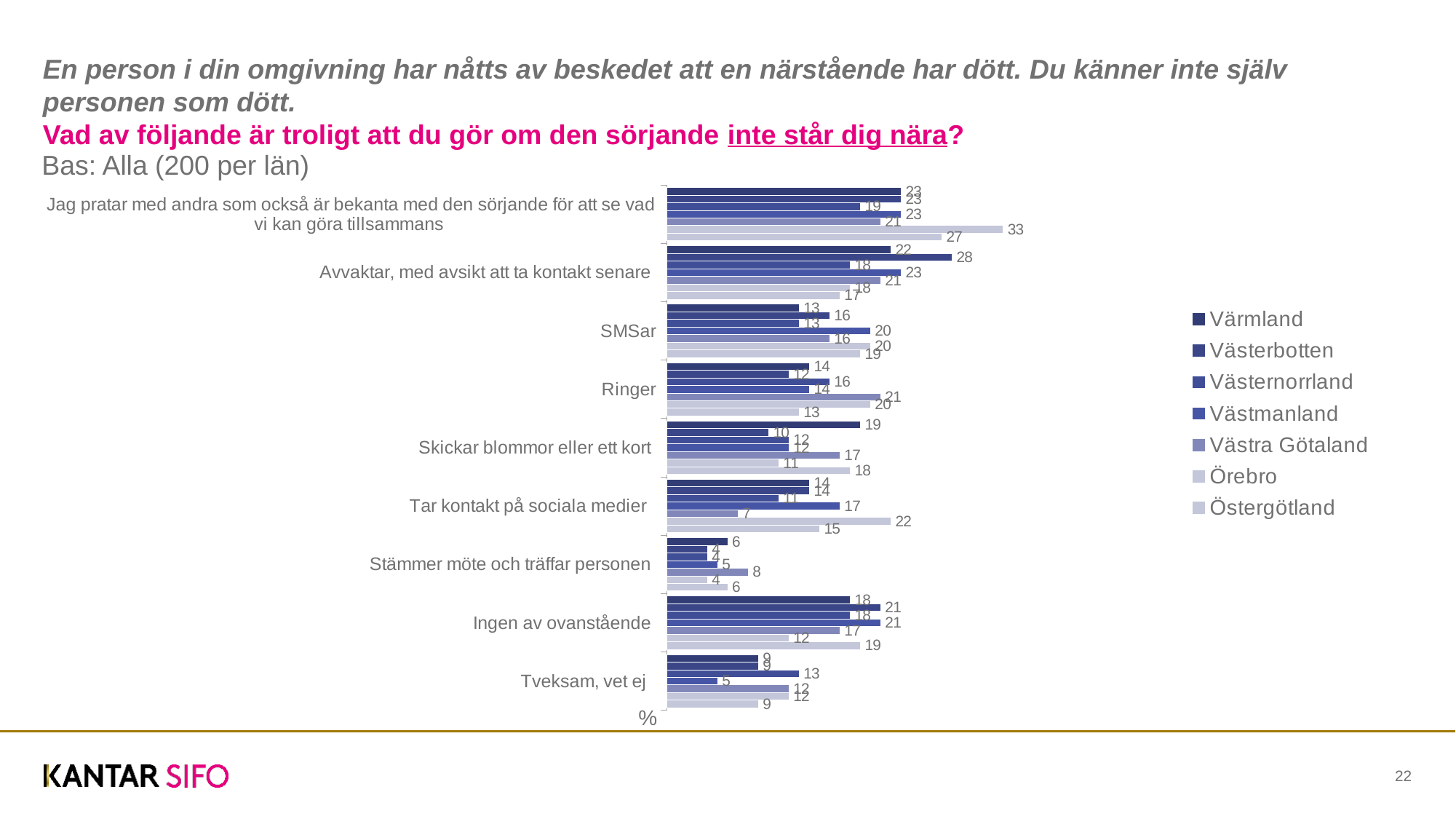
What is the value for Västernorrland in the category 'Tveksam, vet ej'? 13 Which county has the highest value for 'Tar kontakt på sociala medier'? Örebro Which county has the highest value for 'Jag pratar med andra som också är bekanta med den sörjande för att se vad vi kan göra tillsammans'? Örebro Which county has the lowest value for 'Tar kontakt på sociala medier'? Västra Götaland How many response categories are plotted on the chart? 9 For 'Avvaktar, med avsikt att ta kontakt senare', which is larger: Västerbotten or Östergötland? Västerbotten What kind of chart is shown on the slide? bar chart What is the value for Västra Götaland in the category 'Stämmer möte och träffar personen'? 8 What is the value for Västerbotten in the category 'Avvaktar, med avsikt att ta kontakt senare'? 28 What is the value for Örebro in the category 'Jag pratar med andra som också är bekanta med den sörjande för att se vad vi kan göra tillsammans'? 33 What is the difference between Östergötland and Västra Götaland for 'Tar kontakt på sociala medier'? 8 How many series (counties) does the legend list? 7